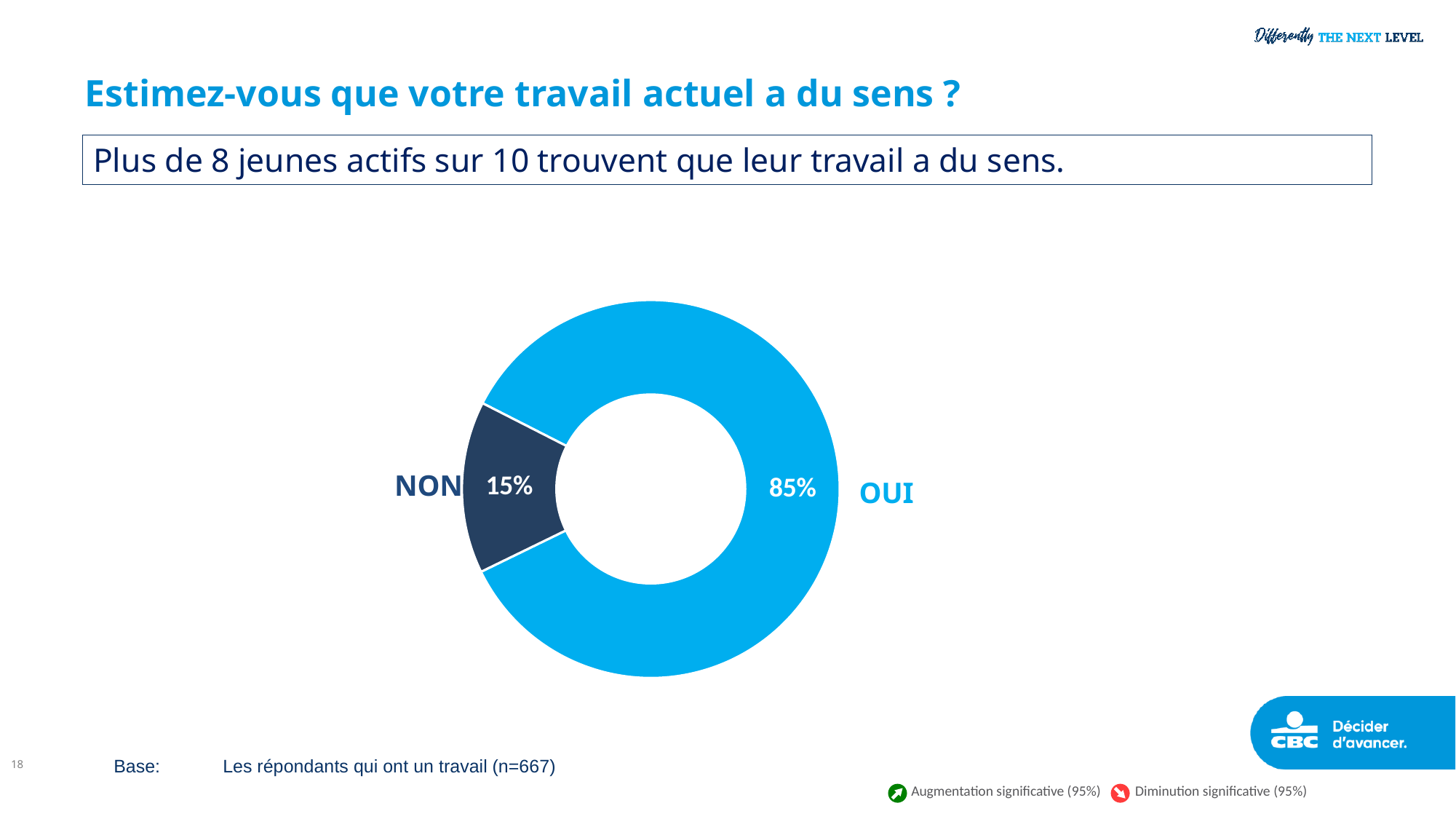
What is the total of the two slices shown in the chart? 100% What is the base (number of respondents) stated for the chart? n=667 Which is larger, the share for OUI or the share for NON? OUI What percentage of respondents answered NON? 15% What is the difference in percentage points between OUI and NON? 70 Which category has the largest share of the chart? OUI How many categories are shown in the chart? 2 Which category has the smallest share of the chart? NON What share of the chart does the OUI slice represent? 85% What percentage of respondents answered OUI? 85% What colour is the NON slice of the chart? Dark navy blue What kind of chart is shown on the slide? Doughnut chart